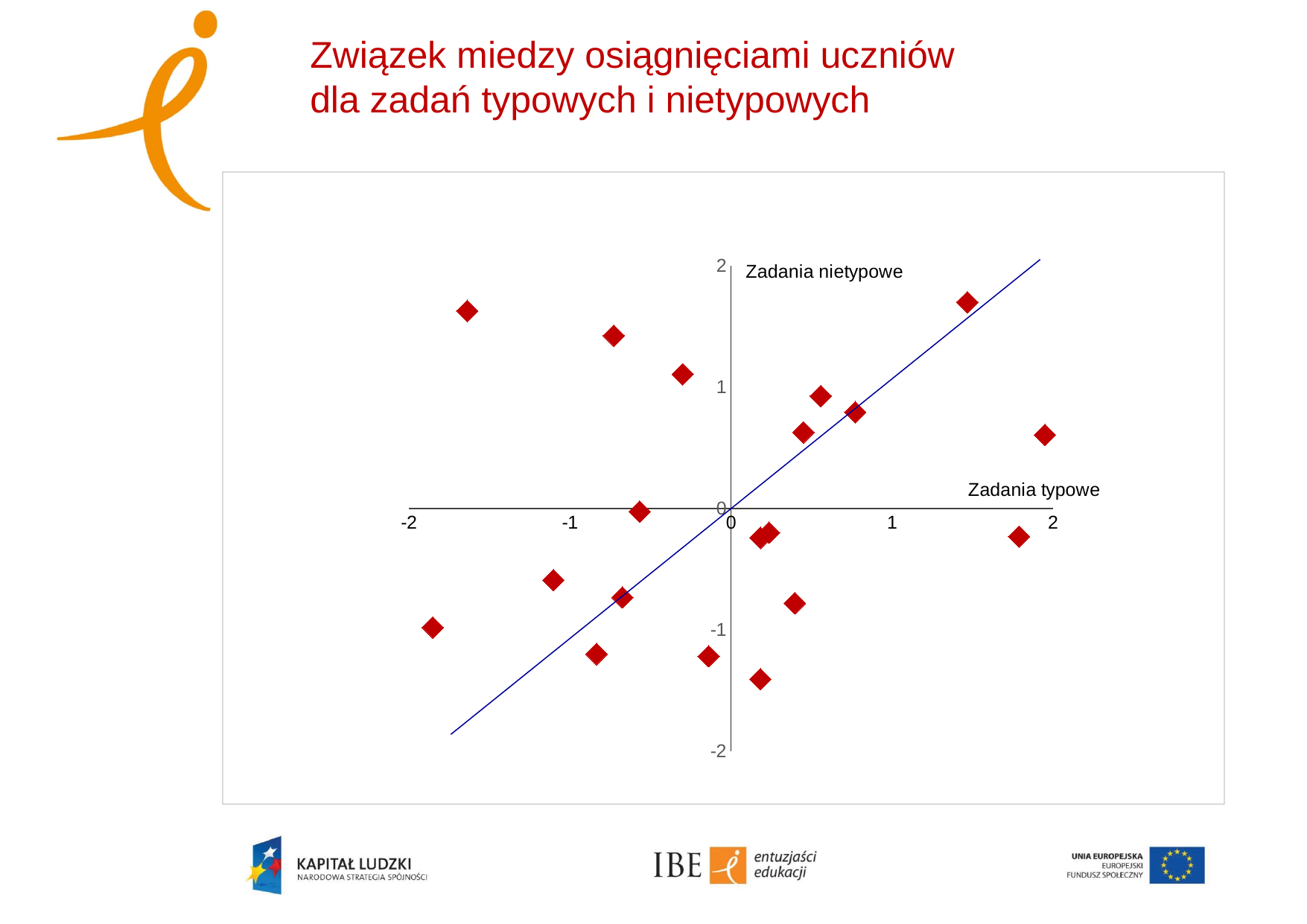
What is the lowest value shown on the horizontal axis of the chart? -2 Is the horizontal-axis value of the highest point in the chart greater or less than 1? greater What kind of chart is shown on the slide? scatter plot Does the fitted line in the chart rise or fall as the horizontal axis value increases? rise Is the vertical-axis value of the leftmost point in the chart greater or less than 0? less What is the label of the horizontal axis of the chart? Zadania typowe Is the vertical-axis value of the rightmost point in the chart greater or less than 1? less What is the highest value shown on the vertical axis of the chart? 2 What is the label of the vertical axis of the chart? Zadania nietypowe